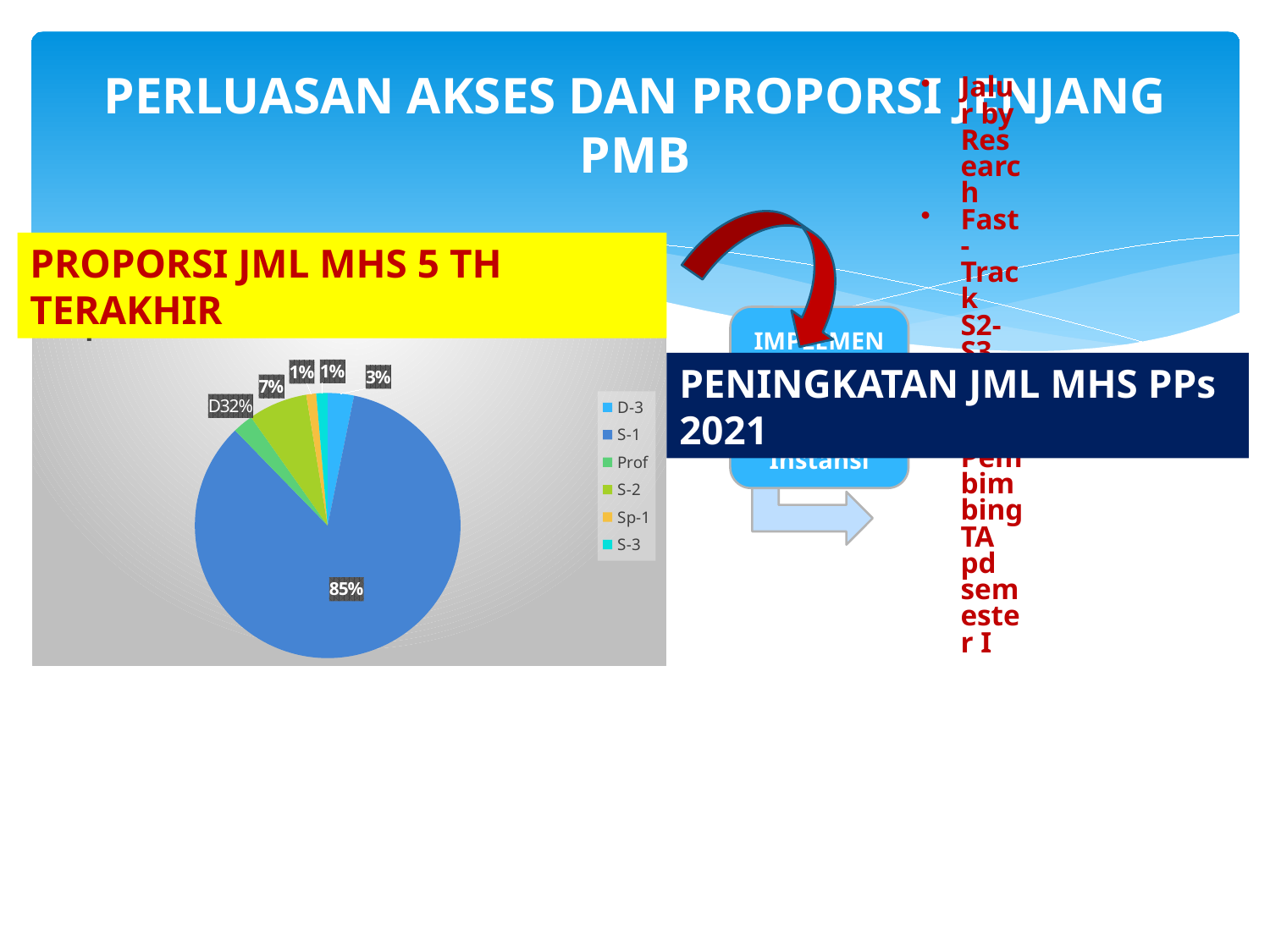
What percentage of the pie chart is D-3? 3% What kind of chart is shown under the heading 'PROPORSI JML MHS 5 TH TERAKHIR'? Pie chart Which category has the largest slice of the pie chart? S-1 What percentage of the pie chart is Sp-1? 1% What percentage of the pie chart is S-1? 85% What is the heading shown above the pie chart? PROPORSI JML MHS 5 TH TERAKHIR How many categories does the pie chart's legend list? 6 What colour is the S-1 slice in the pie chart? Blue Which has a larger share of the pie chart, S-2 or D-3? S-2 What percentage of the pie chart is S-3? 1% What percentage of the pie chart is S-2? 7% By how many percentage points does the S-1 share exceed the S-2 share? 78 percentage points